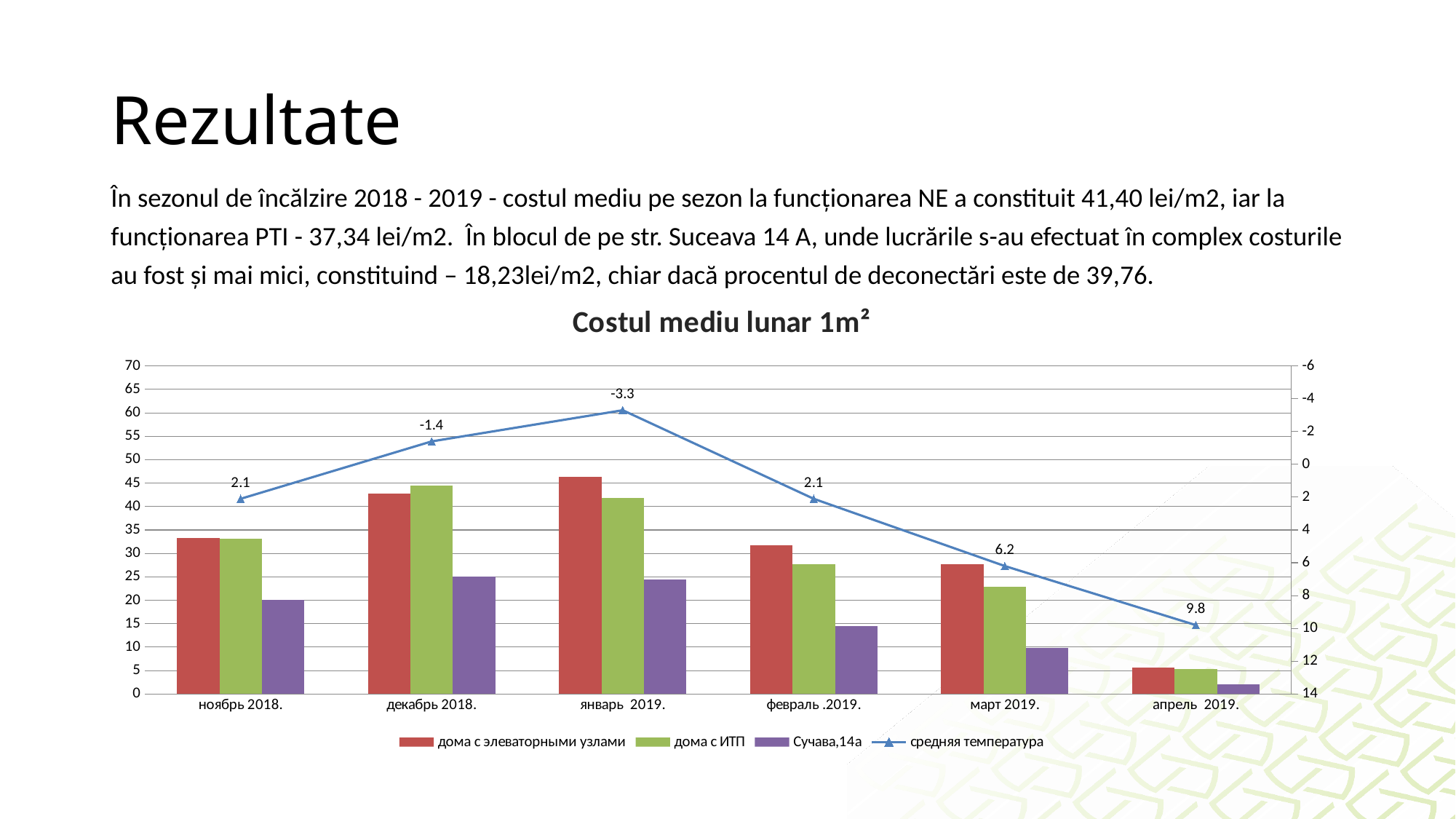
In which month is the value of средняя температура the lowest? январь 2019 What is the value of средняя температура for апрель 2019? 9.8 How many months (categories) are shown on the x axis? 6 How many series does the legend list? 4 Is the value for Сучава,14а in ноябрь 2018 greater or less than 25? less What is the difference between the средняя температура values for апрель 2019 and март 2019? 3.6 What is the value of средняя температура for декабрь 2018? -1.4 What is the title of the chart? Costul mediu lunar 1m² In январь 2019, which is larger: дома с элеваторными узлами or дома с ИТП? дома с элеваторными узлами What is the value of средняя температура for январь 2019? -3.3 In which month is the bar for дома с элеваторными узлами the highest? январь 2019 What kind of chart is this? A combined bar chart and line chart